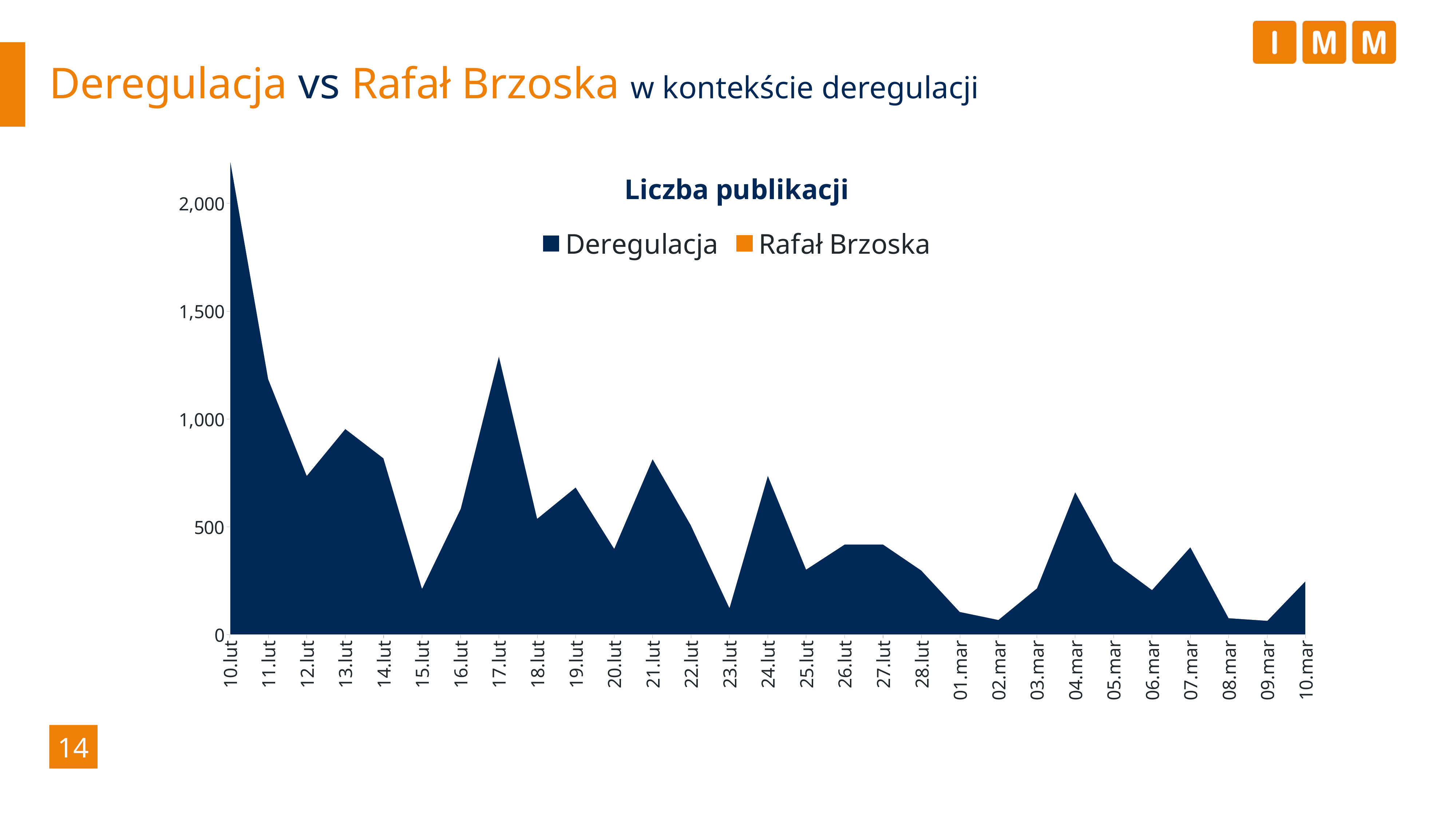
Overall, do the Deregulacja values rise or fall from 10.lut to 10.mar? fall Is the Deregulacja value for 04.mar greater or less than 500? greater What are the two series named in the chart legend? Deregulacja and Rafał Brzoska How many dates are shown on the x axis of the chart? 29 Is the Deregulacja value for 15.lut greater or less than 500? less On which date does the Deregulacja series reach its highest value? 10.lut What kind of chart is shown on the slide? area chart How many series does the chart legend list? 2 Is the Deregulacja value for 10.lut greater or less than 2,000? greater What is the title of the chart? Liczba publikacji Which date has the larger Deregulacja value, 17.lut or 24.lut? 17.lut